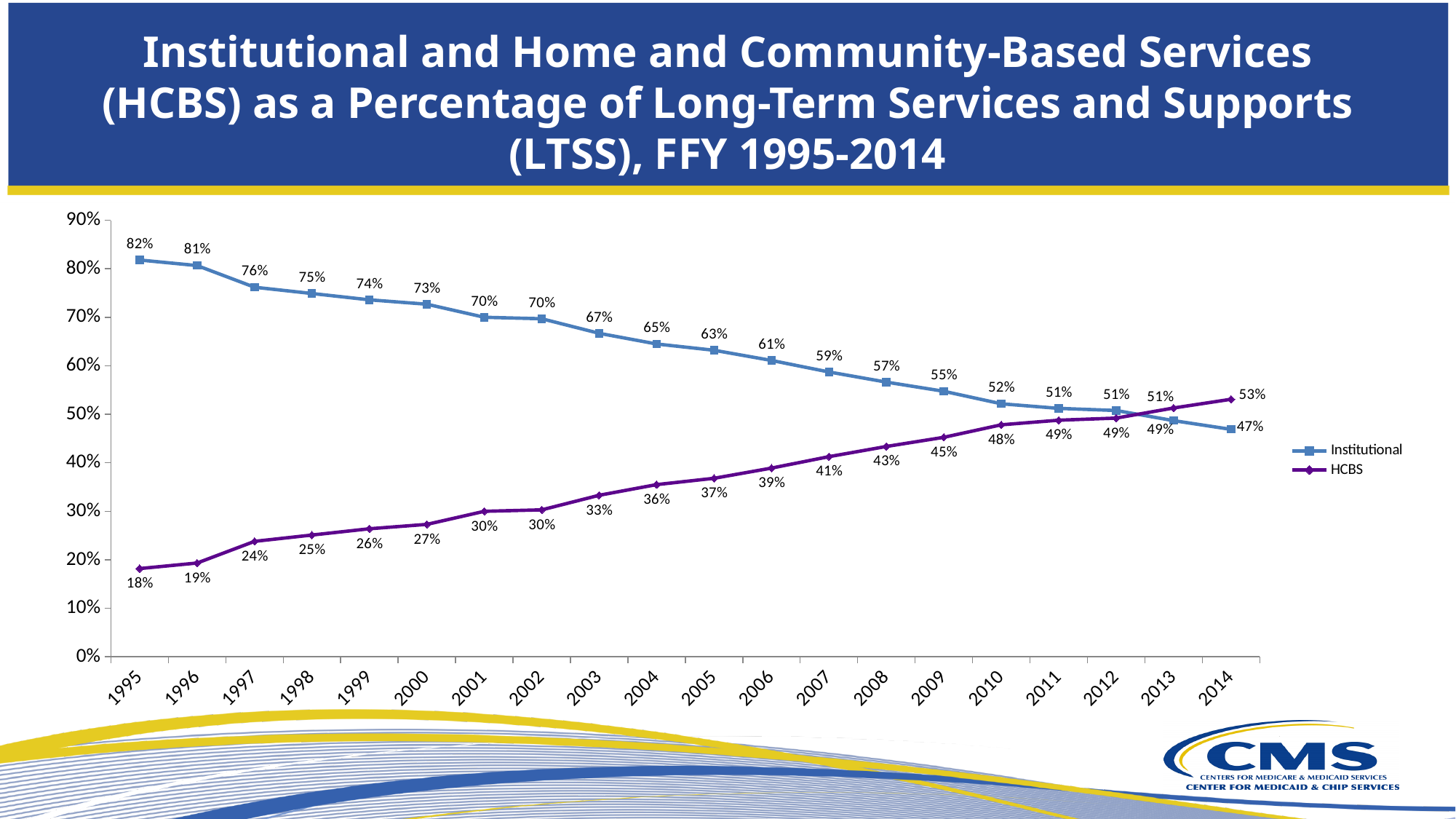
What is the HCBS value for 2014? 53% How many series does the legend list? 2 What is the HCBS value for 2005? 37% In which year is the HCBS series at its highest? 2014 What is the Institutional value for 1995? 82% In which year is the Institutional series at its lowest? 2014 Which is larger in 2010, the Institutional value or the HCBS value? Institutional What kind of chart is shown on the slide? Line chart Does the HCBS series rise or fall from 1995 to 2014? Rise How many years are shown on the x axis? 20 What is the difference between the Institutional and HCBS values in 2000? 46 percentage points Which is larger in 2013, the Institutional value or the HCBS value? HCBS